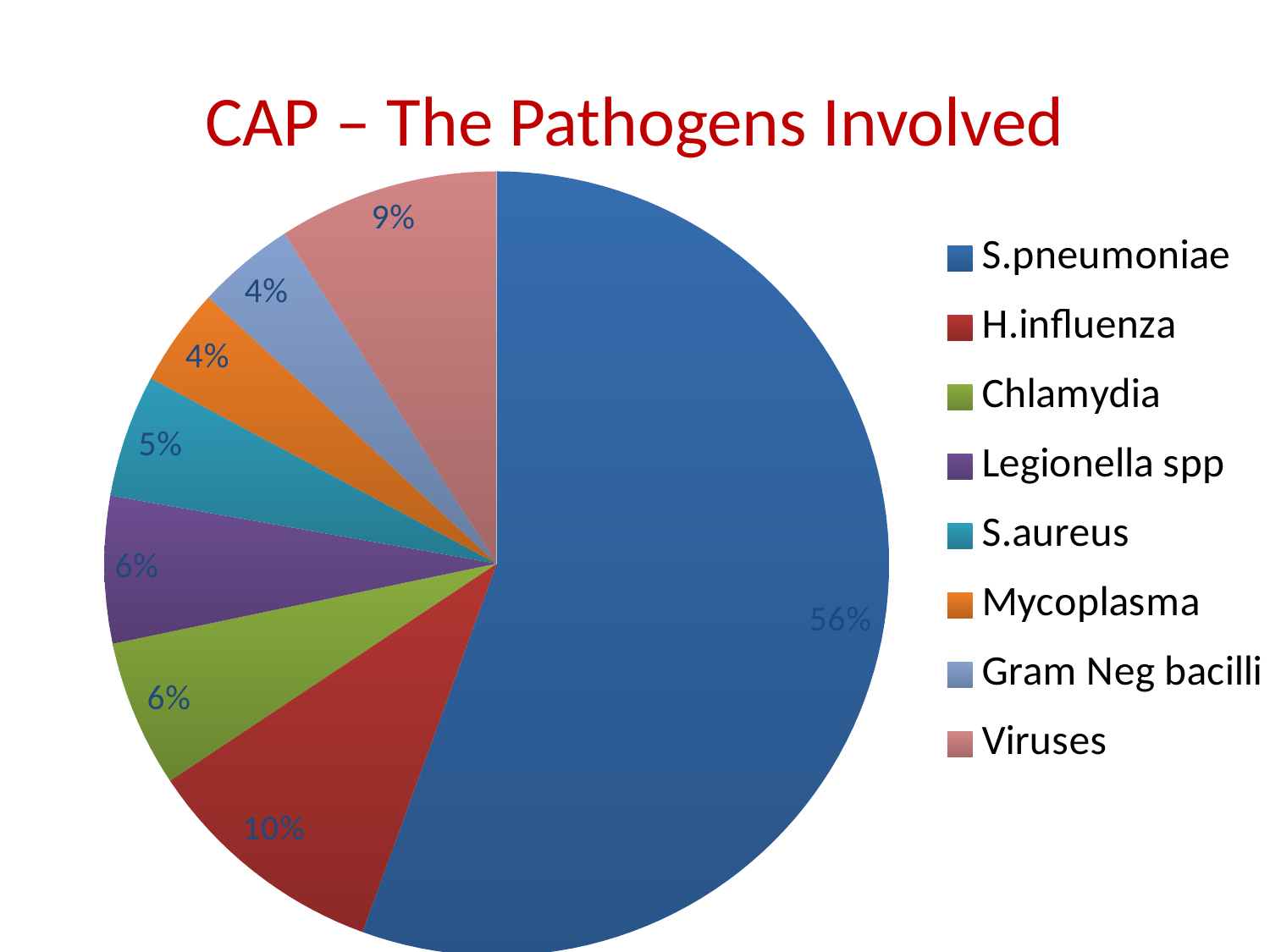
What percentage is shown for H.influenza? 10% What is the difference between the S.pneumoniae share and the H.influenza share? 46% What percentage is shown for S.aureus? 5% What is the difference between the Viruses share and the Mycoplasma share? 5% Which pathogen has the largest slice of the pie? S.pneumoniae What share of the pie does S.pneumoniae account for? 56% Which colour represents Chlamydia in the chart? green Which is larger, the share for Viruses or the share for Legionella spp? Viruses What kind of chart is shown on the slide? pie chart What percentage is shown for Viruses? 9% What is the title of the chart? CAP – The Pathogens Involved How many categories does the legend list? 8